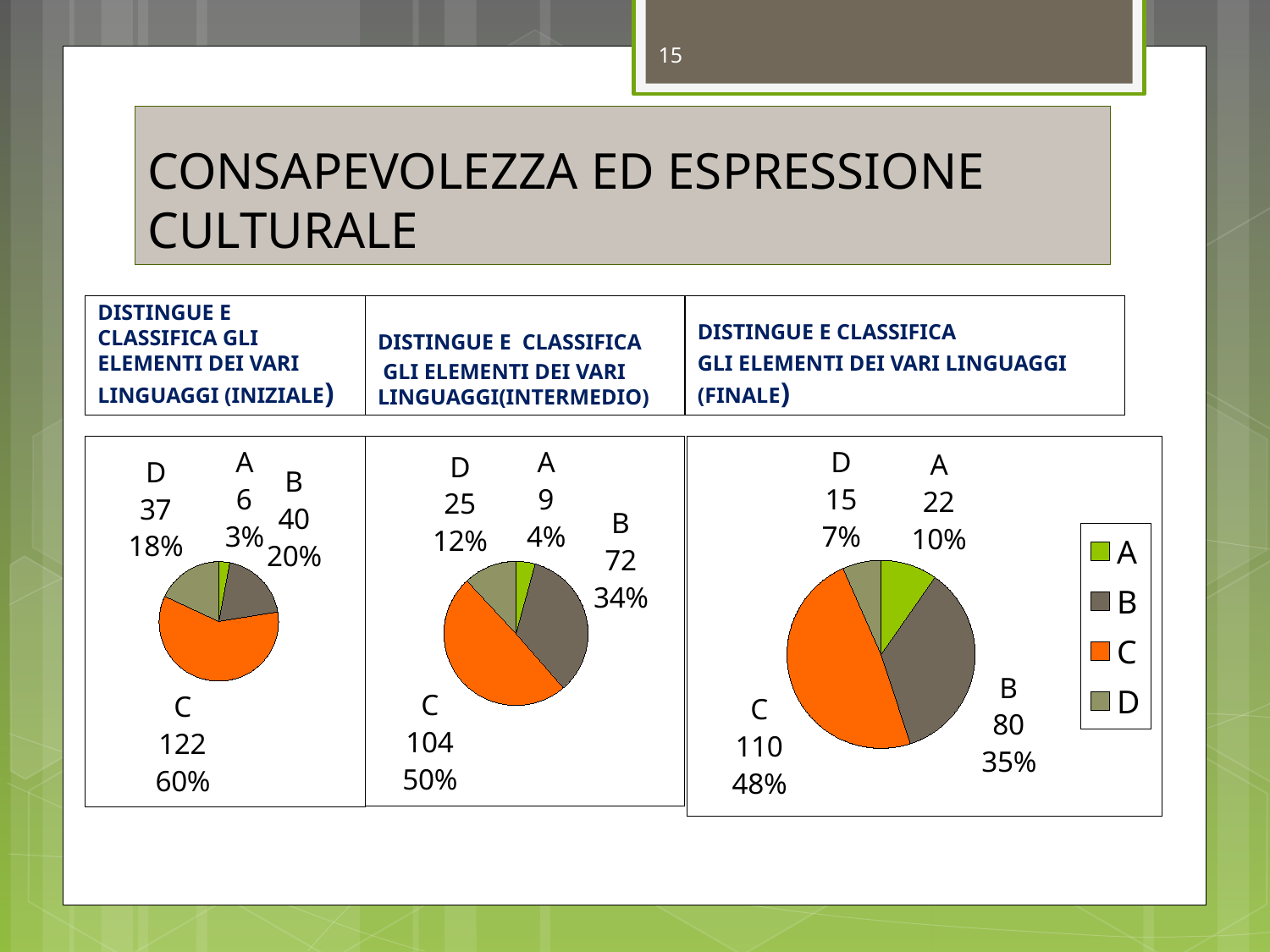
What type of chart is used on this slide? Pie chart In the INTERMEDIO pie chart (middle), what share of the pie does category A represent? 4% In the FINALE pie chart (right), what is the difference between the values for C and B? 30 How many categories does the legend on the right list? 4 According to the legend, which colour represents category C? Orange In the INIZIALE pie chart (left), what value is shown for category C? 122 In the FINALE pie chart (right), which category has the smallest value? D In the INIZIALE pie chart (left), what percentage is shown for category D? 18% In the INTERMEDIO pie chart (middle), what value is shown for category B? 72 In the INTERMEDIO pie chart (middle), which category has the largest value? C In the INIZIALE pie chart (left), which is larger, the value for B or the value for D? B In the FINALE pie chart (right), what percentage is shown for category C? 48%